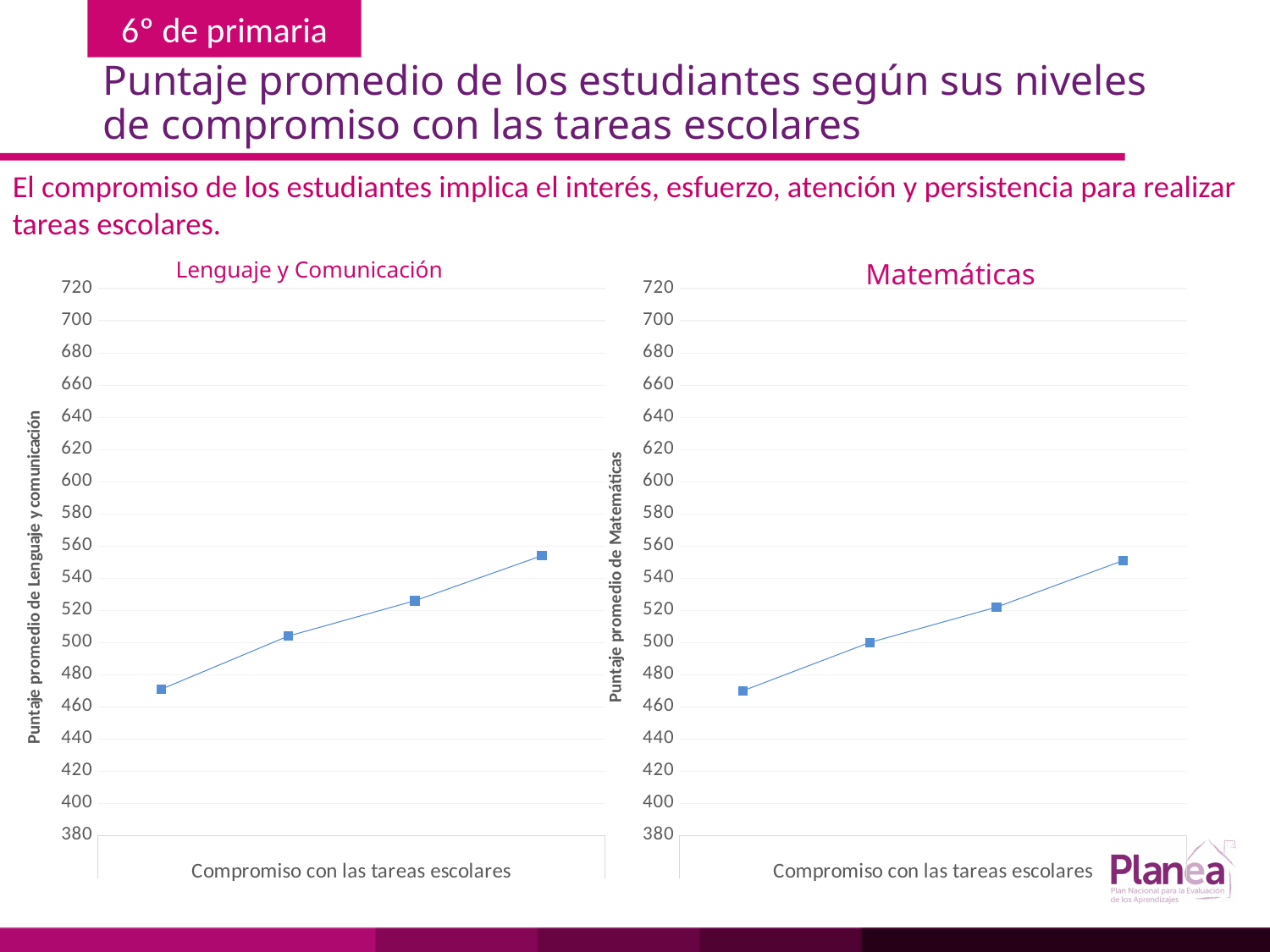
In the Matemáticas chart, is the value of the last (rightmost) point greater or less than 540? greater In the Matemáticas chart, is the value of the first (leftmost) point greater or less than 480? less In the Matemáticas chart, do the values rise or fall from left to right along the x axis? rise What kind of chart is the Lenguaje y Comunicación chart? line chart In the Matemáticas chart, which point has the highest value, the leftmost or the rightmost? the rightmost In the Lenguaje y Comunicación chart, is the value of the first (leftmost) point greater or less than 480? less What kind of chart is the Matemáticas chart? line chart What is the x-axis title of the Lenguaje y Comunicación chart? Compromiso con las tareas escolares In the Lenguaje y Comunicación chart, do the values rise or fall from left to right along the x axis? rise How many data points are plotted in the Lenguaje y Comunicación chart? 4 How many data points are plotted in the Matemáticas chart? 4